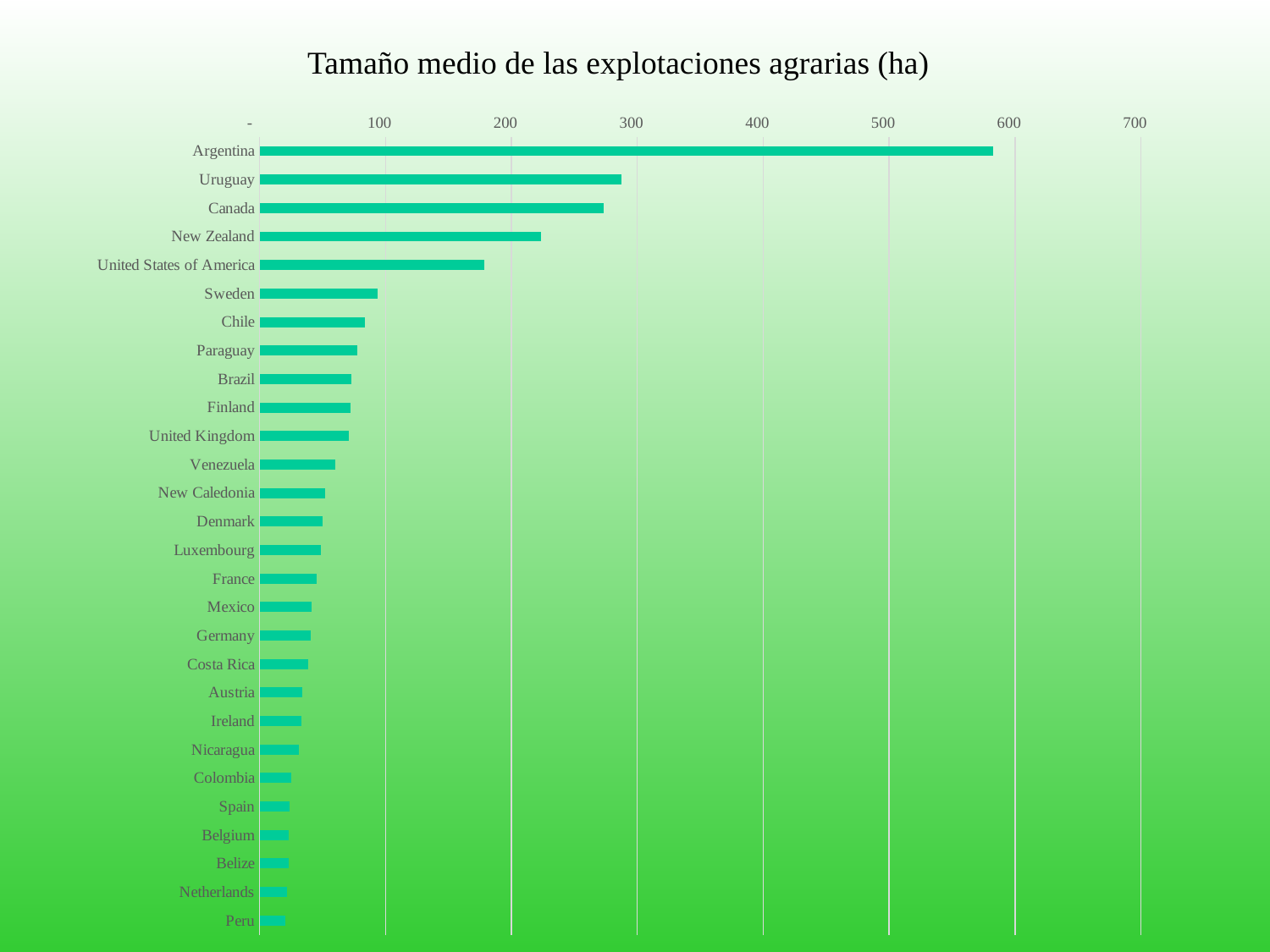
Is the value for Sweden greater or less than 100? less Is the value for Canada greater or less than 200? greater Is the value for United States of America greater or less than 200? less Do the bar values increase or decrease going from the top of the chart to the bottom? decrease How many countries are shown in the chart? 28 Which has a larger value, Argentina or Uruguay? Argentina Which has a larger value, Sweden or Canada? Canada What is the title of the chart? Tamaño medio de las explotaciones agrarias (ha) Which country has the highest value in the chart? Argentina What kind of chart is shown on the slide? bar chart